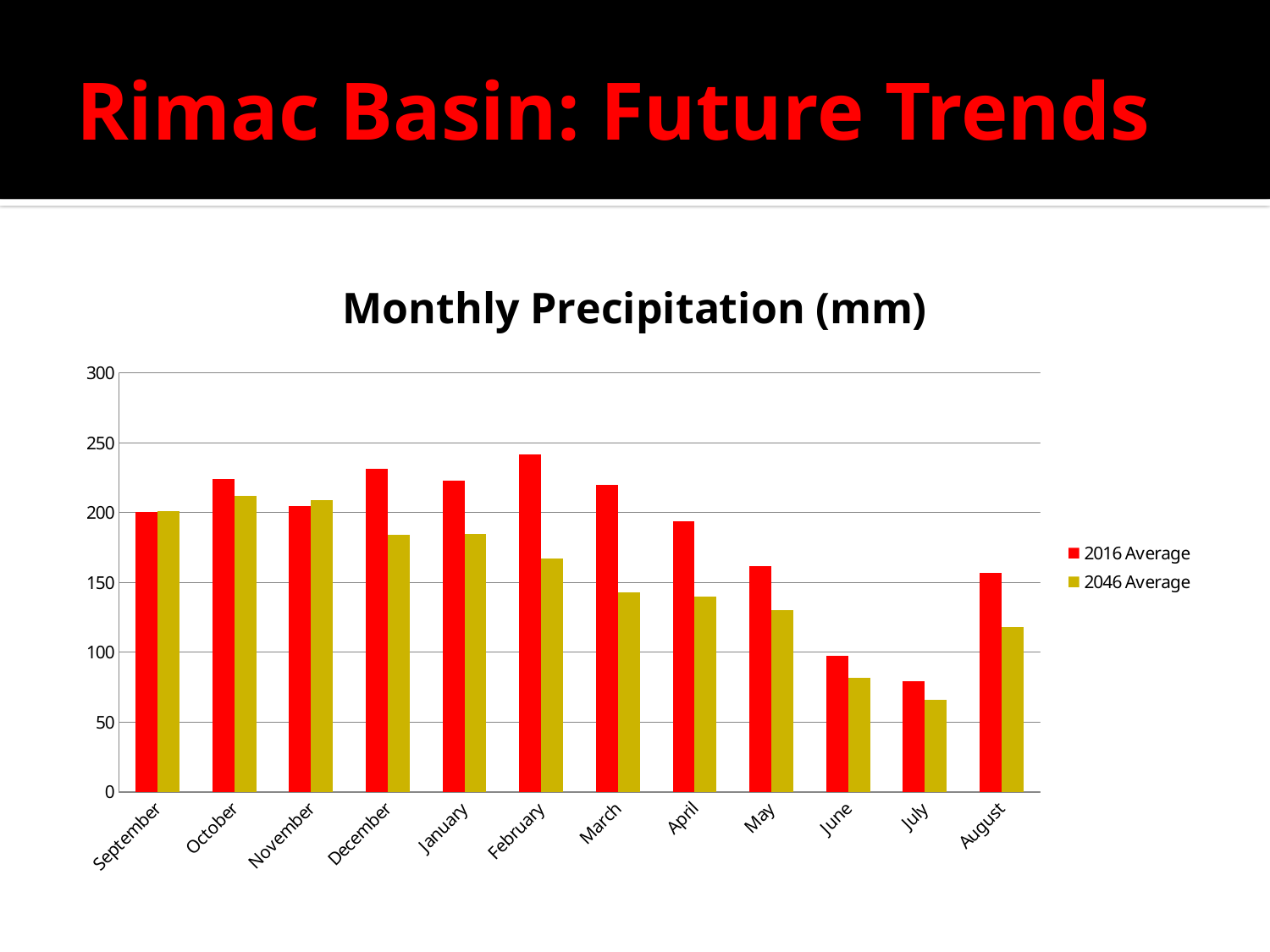
How many series does the legend list? 2 Which month has the lowest 2046 Average precipitation? July Do the 2016 Average values rise or fall from February through July? fall What kind of chart is shown on the slide? Bar chart Is the 2046 Average value for March greater or less than 150? less Is the 2016 Average value for July greater or less than 100? less Which month has the lowest 2016 Average precipitation? July What is the title of the chart? Monthly Precipitation (mm) Is the 2016 Average value for February greater or less than 200? greater Which month has the highest 2016 Average precipitation? February For December, which is larger: the 2016 Average or the 2046 Average? 2016 Average How many months are shown on the x axis? 12